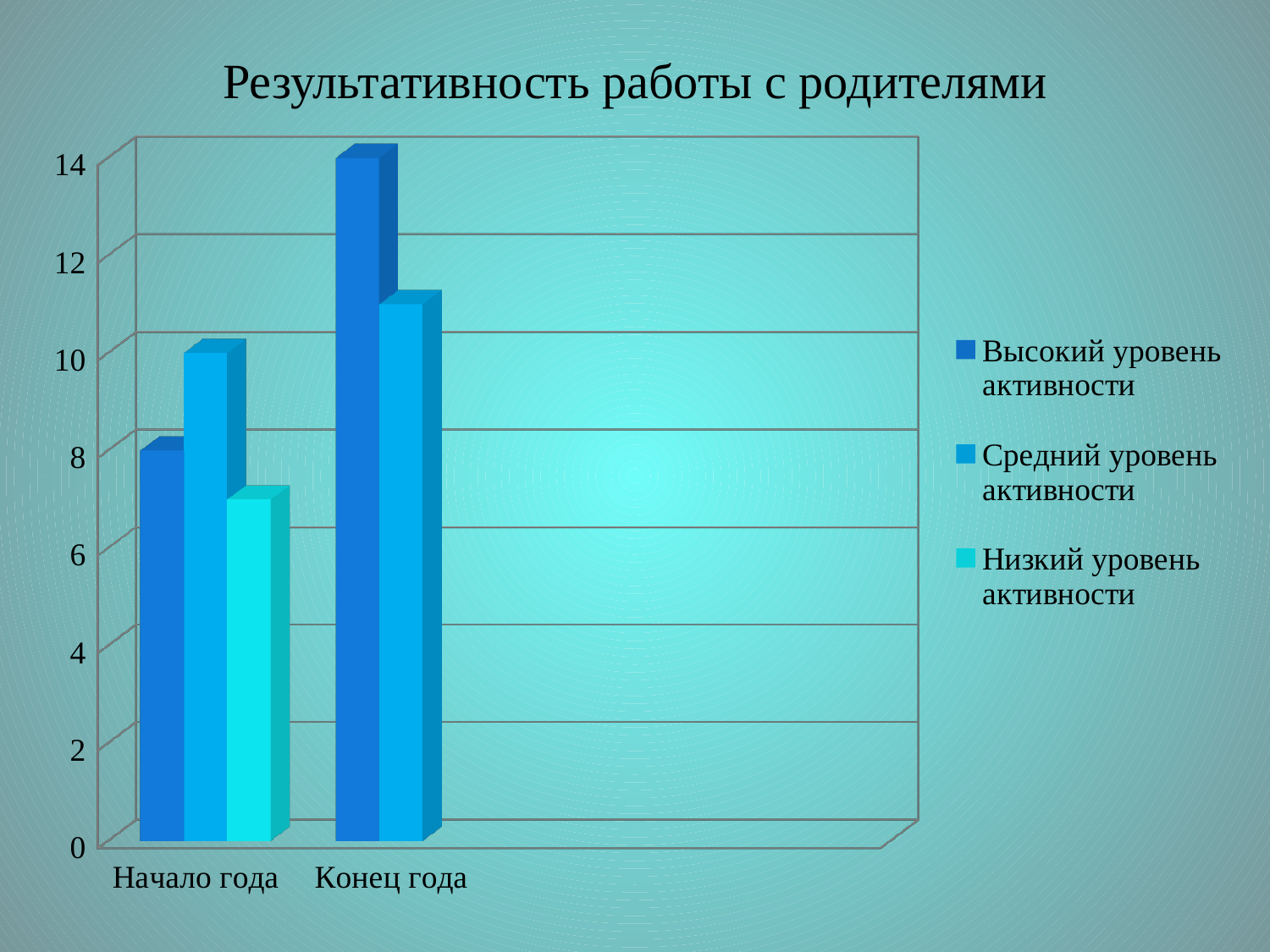
What is the value for Высокий уровень активности at Начало года? 8 Is the value for Низкий уровень активности at Начало года greater or less than 8? less Is the value for Средний уровень активности at Конец года greater or less than 10? greater What is the title of the chart? Результативность работы с родителями What is the value for Средний уровень активности at Начало года? 10 By how much does Высокий уровень активности increase from Начало года to Конец года? 6 What kind of chart is shown on the slide? bar chart How many categories are shown on the x axis? 2 How many series does the legend list? 3 Which series has the highest value at Начало года? Средний уровень активности Which series has the highest value at Конец года? Высокий уровень активности What is the value for Высокий уровень активности at Конец года? 14